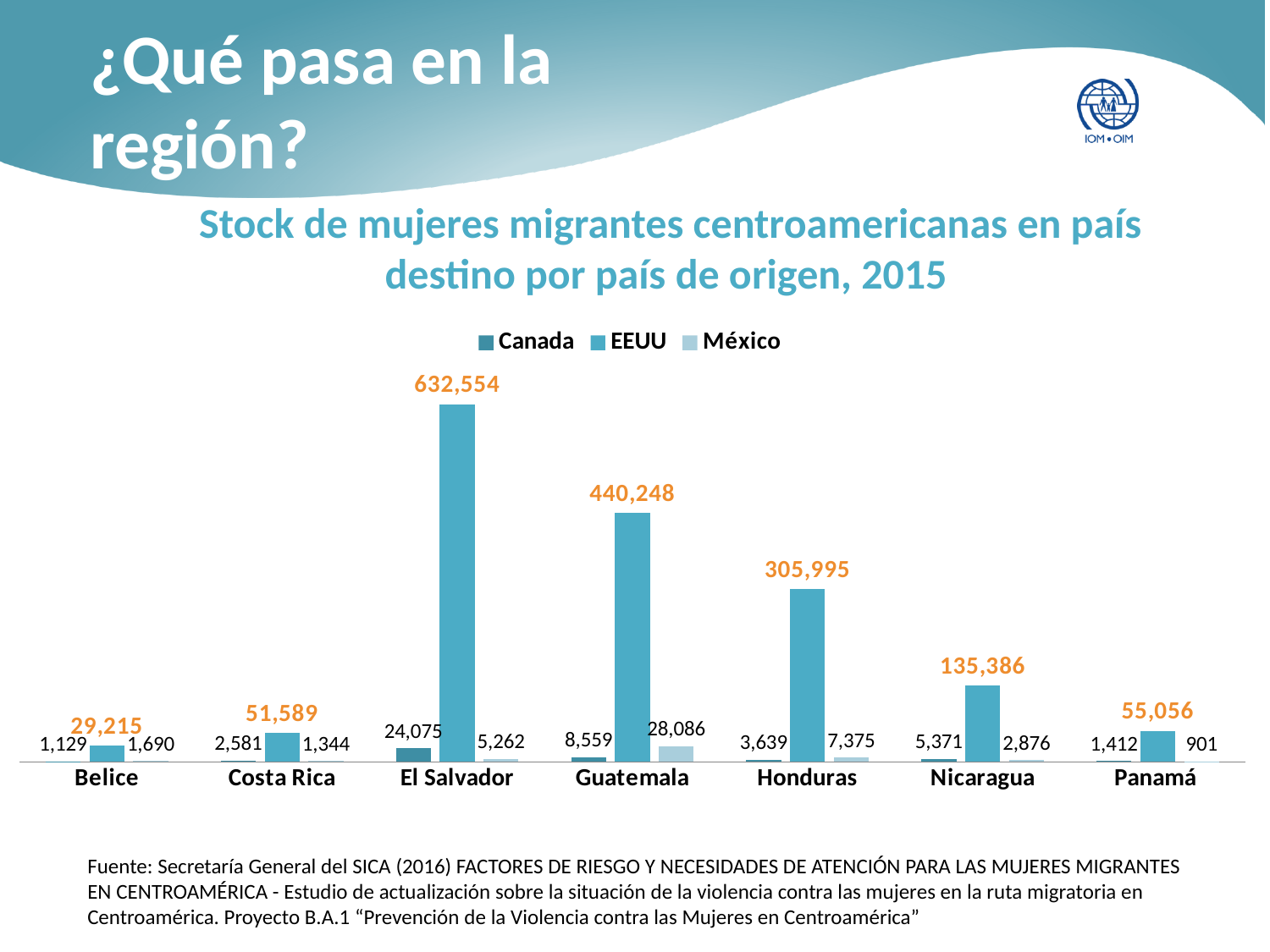
Which series is shown in the lightest blue colour in the legend? México Which country of origin has the lowest México value? Panamá What kind of chart is shown on the slide? Bar chart What is the difference between the EEUU values for El Salvador and Guatemala? 192,306 Which country of origin has the highest EEUU value? El Salvador What is the México value for Honduras? 7,375 How many series does the legend list? 3 Which is larger, the Canada value for Nicaragua or the Canada value for Honduras? Nicaragua What is the EEUU value for El Salvador? 632,554 What is the difference between the México and Canada values for Belice? 561 How many countries of origin are shown on the x axis? 7 What is the Canada value for Guatemala? 8,559